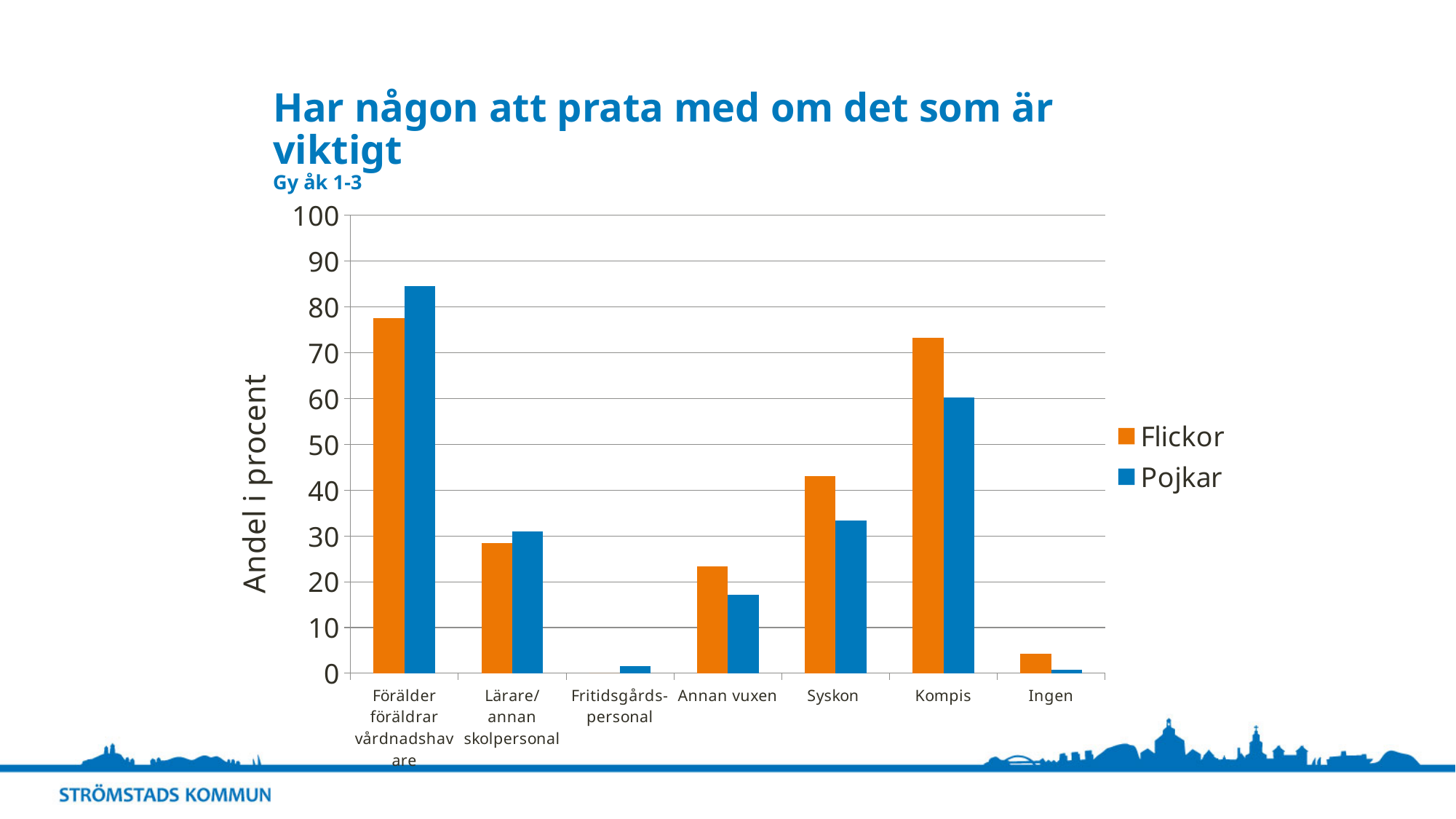
Which category has the highest value for Flickor? Förälder föräldrar vårdnadshavare For the Kompis category, which series has the larger value, Flickor or Pojkar? Flickor How many categories are shown on the x axis? 7 For the Förälder föräldrar vårdnadshavare category, which series has the larger value, Flickor or Pojkar? Pojkar How many series does the legend list? 2 What is the label of the y axis? Andel i procent Is the value for Flickor in the Kompis category greater or less than 70? greater Is the value for Pojkar in the Förälder föräldrar vårdnadshavare category greater or less than 80? greater Is the value for Pojkar in the Syskon category greater or less than 40? less Which category has the highest value for Pojkar? Förälder föräldrar vårdnadshavare What kind of chart is shown on the slide? bar chart Which category has the lowest value for Flickor? Fritidsgårds-personal